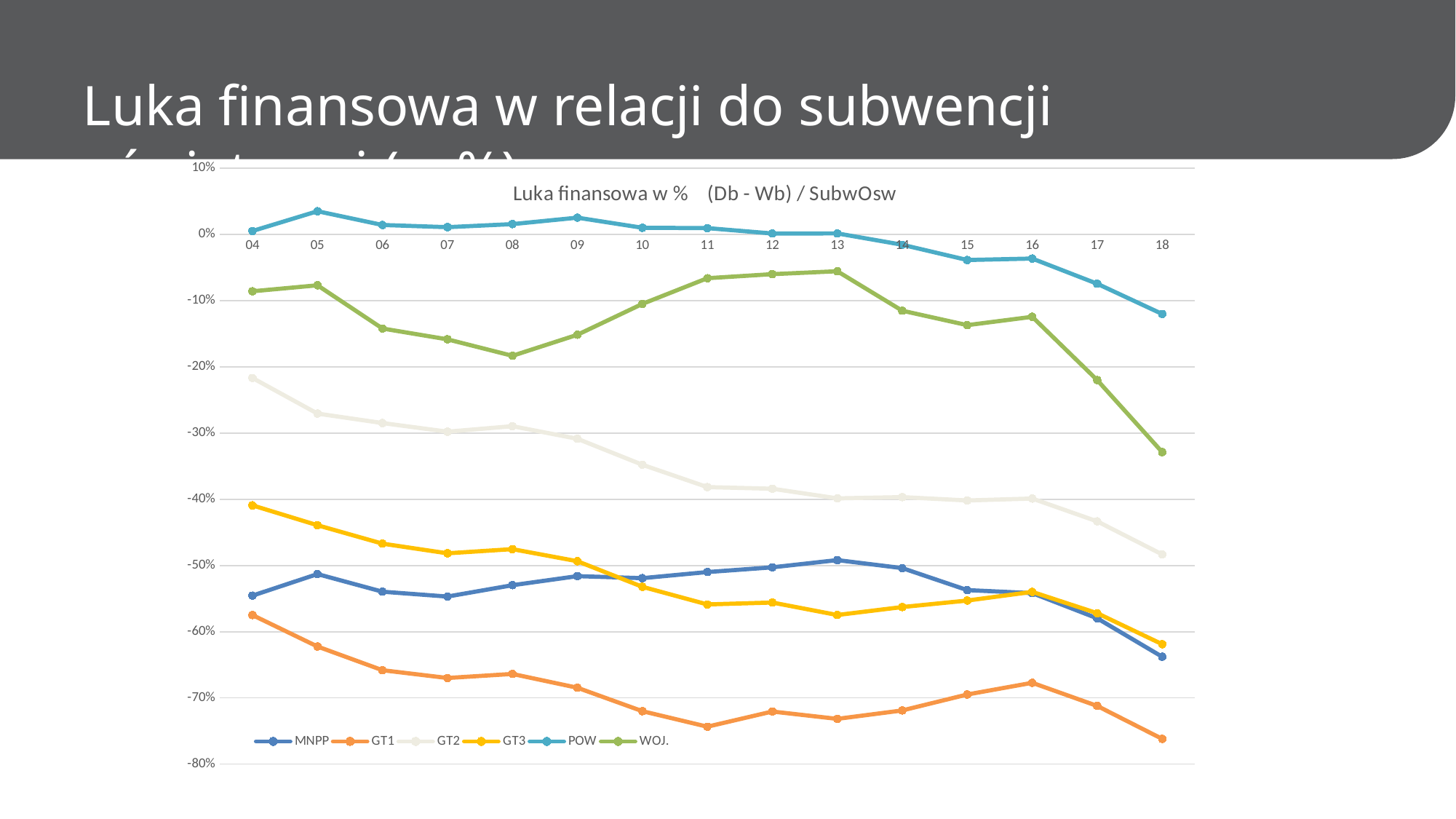
Does the POW series rise or fall from 13 to 18? fall Is the value for GT1 at 18 greater or less than -70%? less How many series does the legend list? 6 What kind of chart is shown on the slide? line chart At 04, which is larger: the value for GT2 or the value for GT3? GT2 Which series has the lowest value at 18? GT1 What is the title of the chart? Luka finansowa w % (Db - Wb) / SubwOsw Is the value for GT2 at 18 greater or less than -40%? less Is the value for POW at 05 greater or less than 0%? greater How many points are on the x axis of the chart? 15 Which series has the highest value at 04? POW